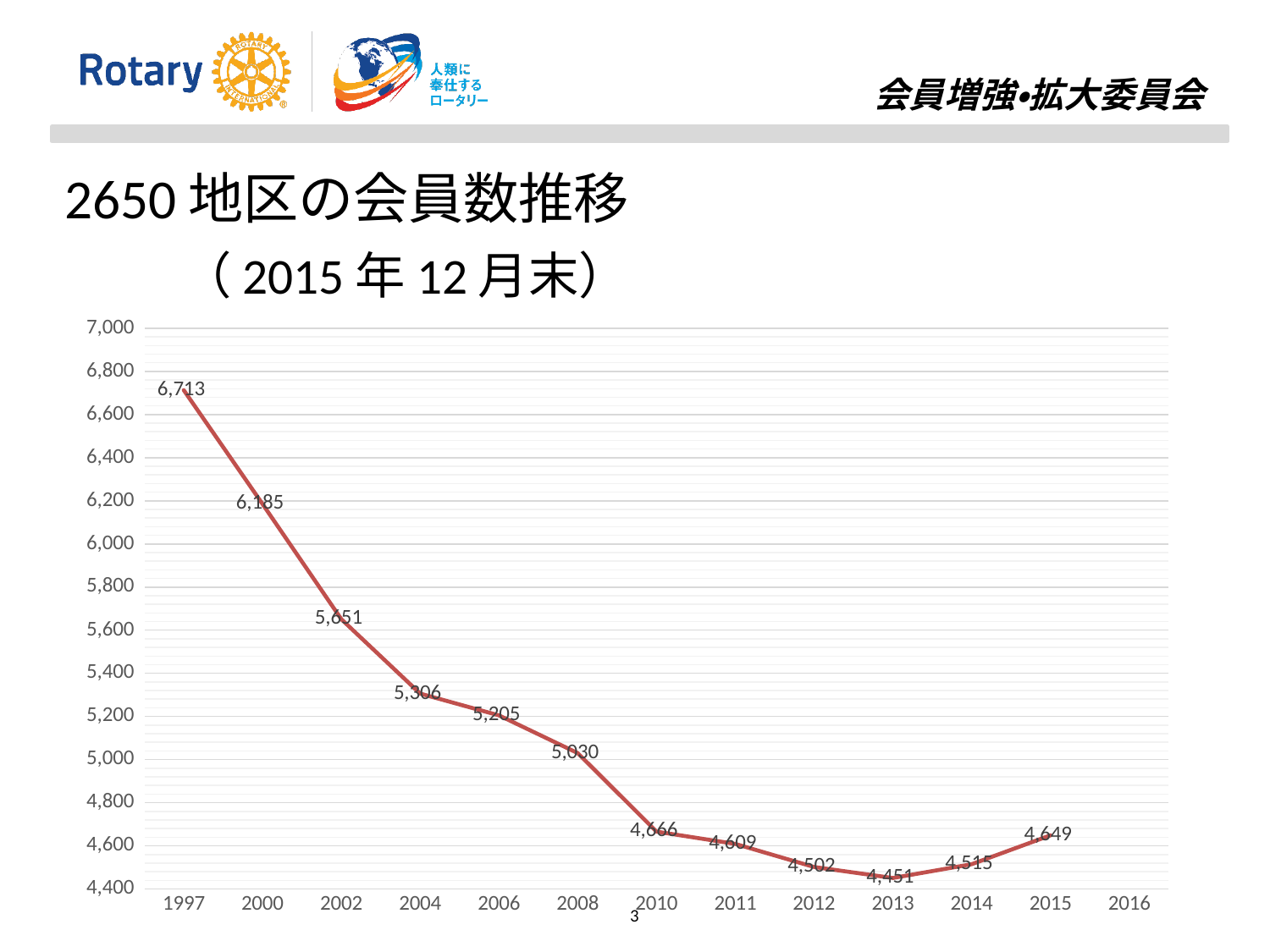
What kind of chart is shown on the slide? Line chart What is the value plotted for 2013? 4,451 What is the overall trend of the values from 1997 to 2013? Falling By how much did the value change from 2013 to 2014? 64 Which year has the lowest value on the chart? 2013 Is the value for 2008 greater or less than 5,000? greater What is the value shown for 2015? 4,649 Which is larger, the value for 2010 or the value for 2011? 2010 What is the difference between the values for 1997 and 2015? 2,064 How many data points are labelled with values on the line? 12 Which year has the highest value on the chart? 1997 What is the membership value shown for 1997? 6,713